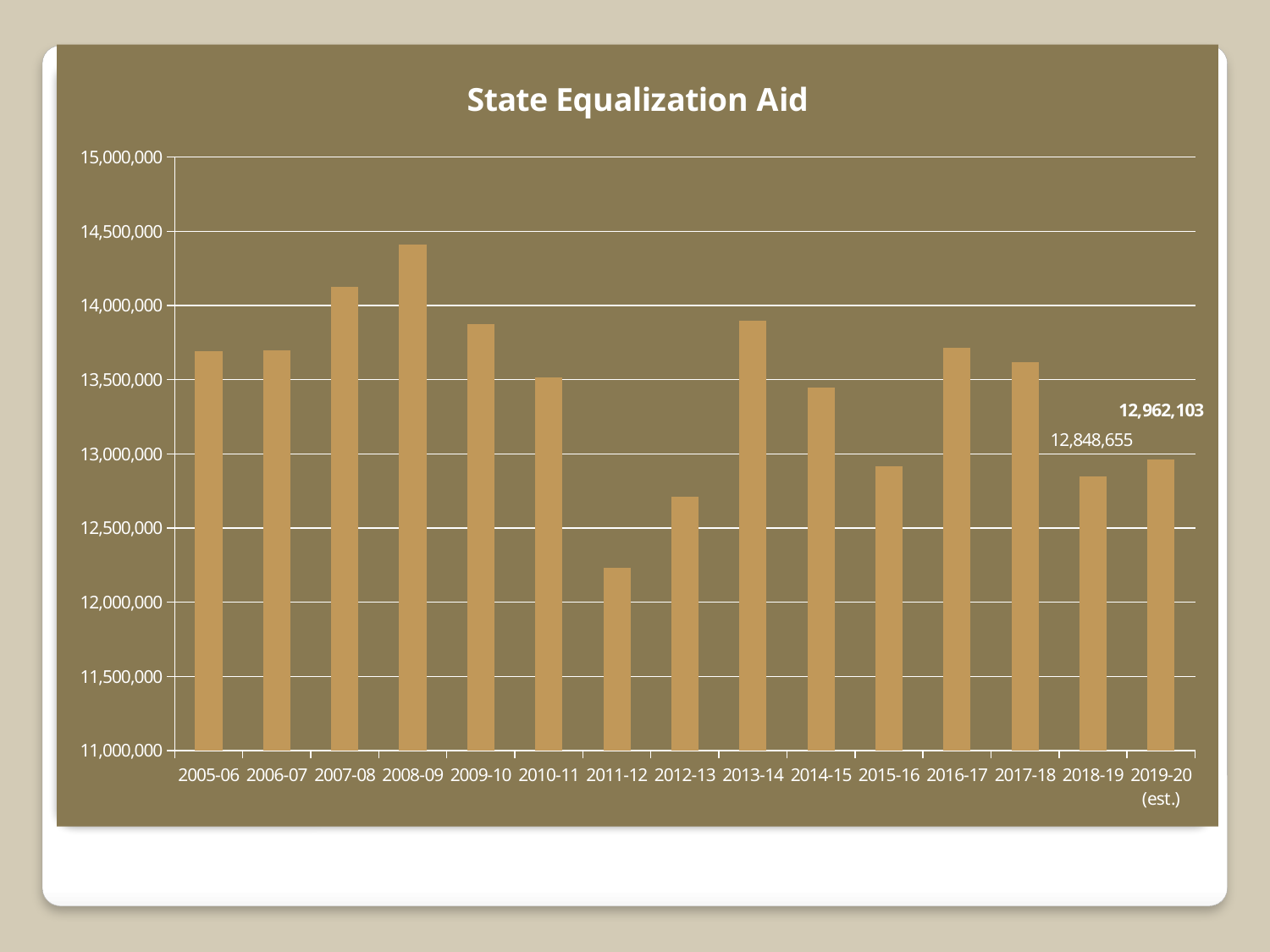
Which year has the lowest State Equalization Aid? 2011-12 What is the value for 2019-20 (est.)? 12,962,103 What is the title of the chart? State Equalization Aid Is the value for 2008-09 greater or less than 14,000,000? greater Is the value for 2011-12 greater or less than 12,500,000? less What is the value for 2018-19? 12,848,655 What type of chart is shown on the slide? bar chart What is the difference between the values for 2019-20 (est.) and 2018-19? 113,448 Which is larger, the value for 2013-14 or the value for 2014-15? 2013-14 How many fiscal years are shown on the x axis? 15 Which year has the highest State Equalization Aid? 2008-09 Do the values rise or fall from 2008-09 to 2011-12? fall